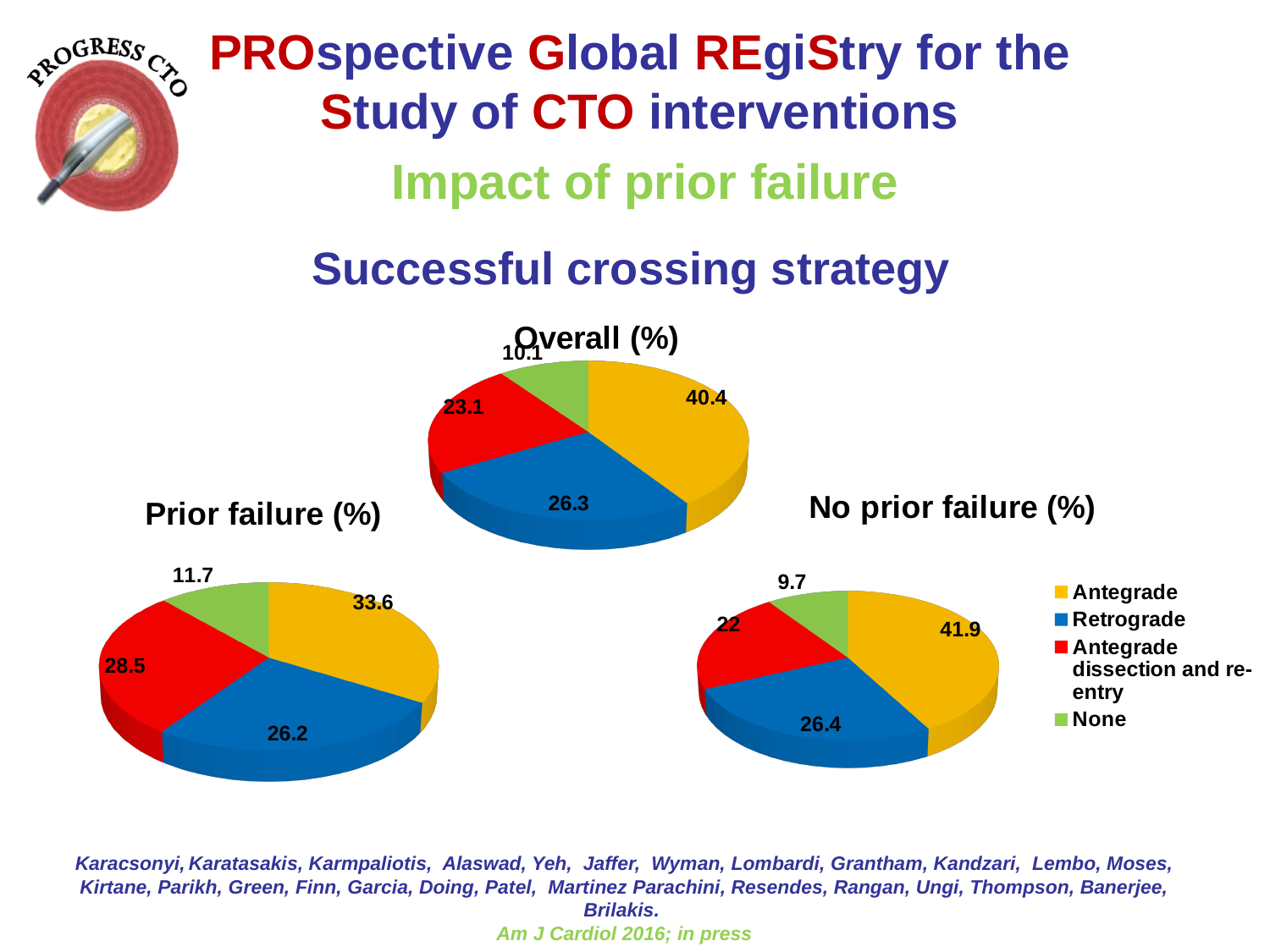
In the No prior failure (%) chart, what is the value for None? 9.7 Which colour represents Retrograde in the legend? Blue In the Overall (%) chart, what is the value for Antegrade? 40.4 In the Prior failure (%) chart, which category has the largest slice? Antegrade Is the Antegrade value larger in the Prior failure (%) chart or the No prior failure (%) chart? No prior failure (%) How many slices does the Overall (%) pie chart have? 4 In the Prior failure (%) chart, which is larger: Retrograde or Antegrade dissection and re-entry? Antegrade dissection and re-entry In the Overall (%) chart, which category has the smallest slice? None In the Prior failure (%) chart, what is the value for Antegrade dissection and re-entry? 28.5 What type of chart is used for the Prior failure (%) data? Pie chart In the No prior failure (%) chart, what is the difference between the Antegrade and Retrograde values? 15.5 How many entries does the legend list? 4